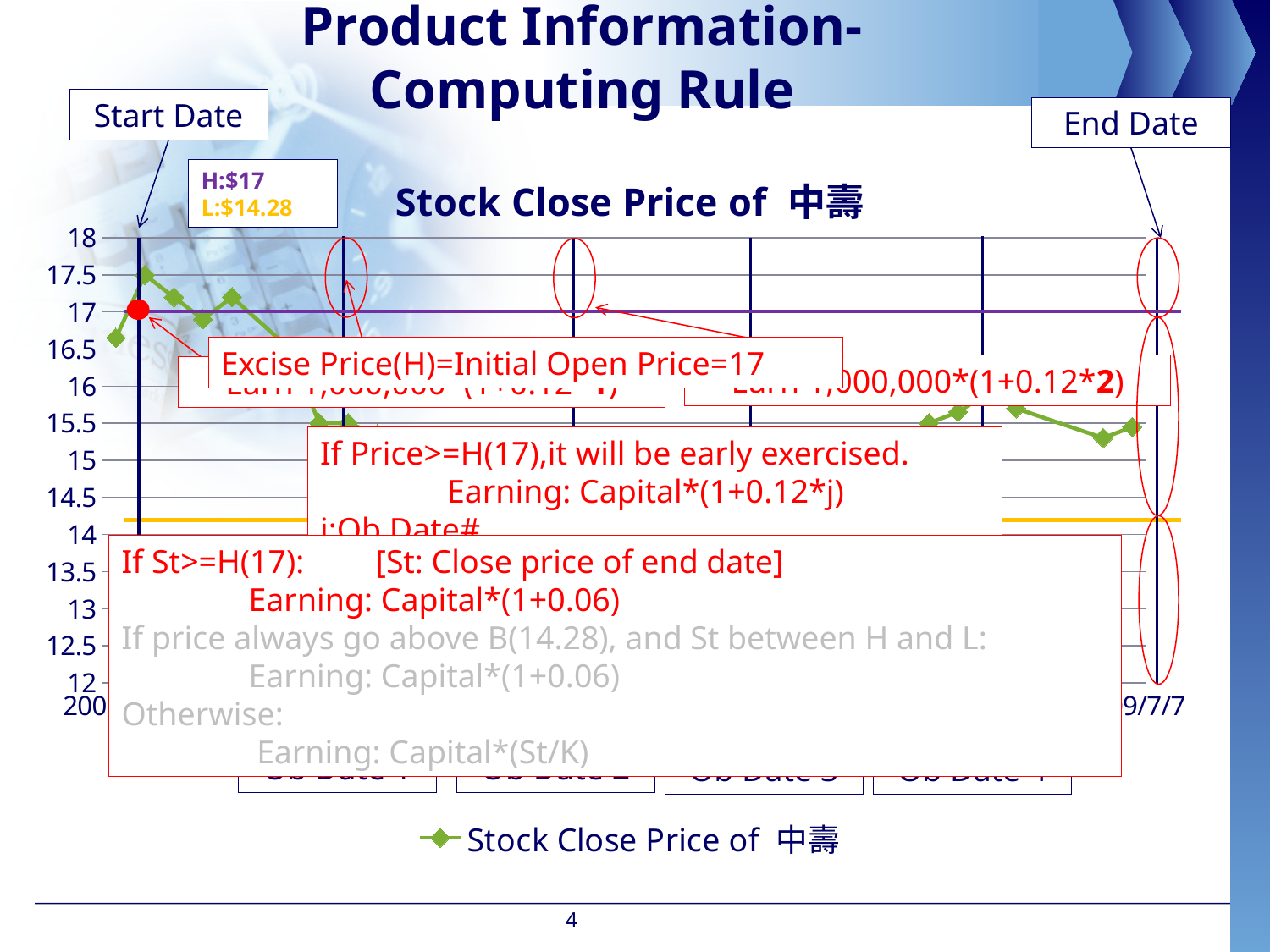
Overall, does the stock close price line rise or fall from the start date to the end date? fall How many series does the chart legend list? 1 What is the highest value shown on the chart's y axis? 18 What is the lowest value shown on the chart's y axis? 12 What is the title of the chart? Stock Close Price of 中壽 What is the name of the series shown in the legend? Stock Close Price of 中壽 Is the last plotted point of the stock close price line greater or less than 16? less What type of chart is shown on the slide? line chart Is the first plotted point of the stock close price line greater or less than 16? greater